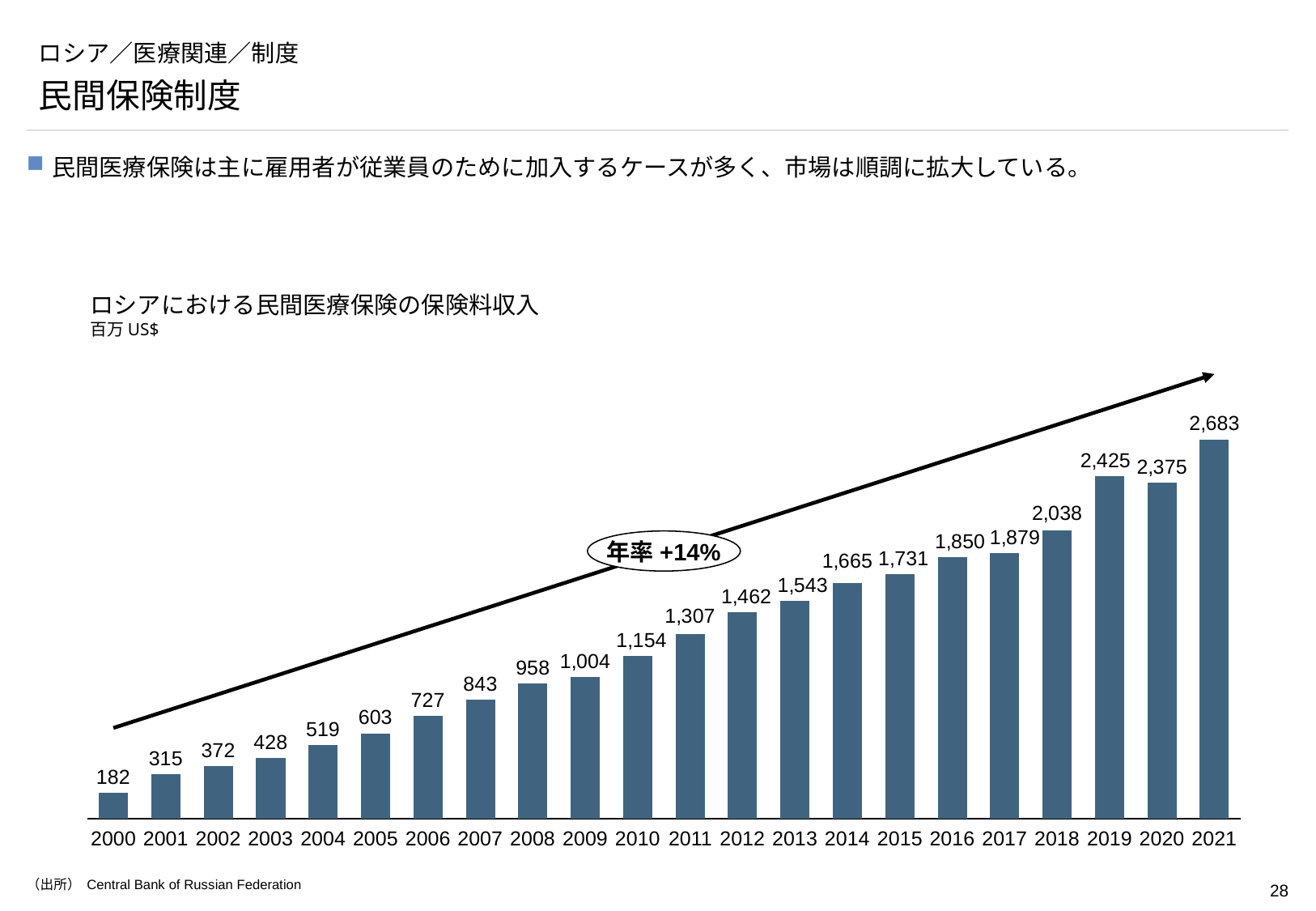
What annual growth rate is shown in the oval label on the chart? 年率 +14% Which year has the lowest value? 2000 Which is larger, the value for 2019 or the value for 2020? 2019 What kind of chart is this? bar chart How many years are shown on the x axis? 22 What is the difference between the values for 2021 and 2020? 308 What is the value for 2010? 1,154 What is the value for 2021? 2,683 Which year has the highest value? 2021 What is the value for 2000? 182 Do the values generally rise or fall from 2000 to 2021? rise What unit is stated under the chart title? 百万 US$